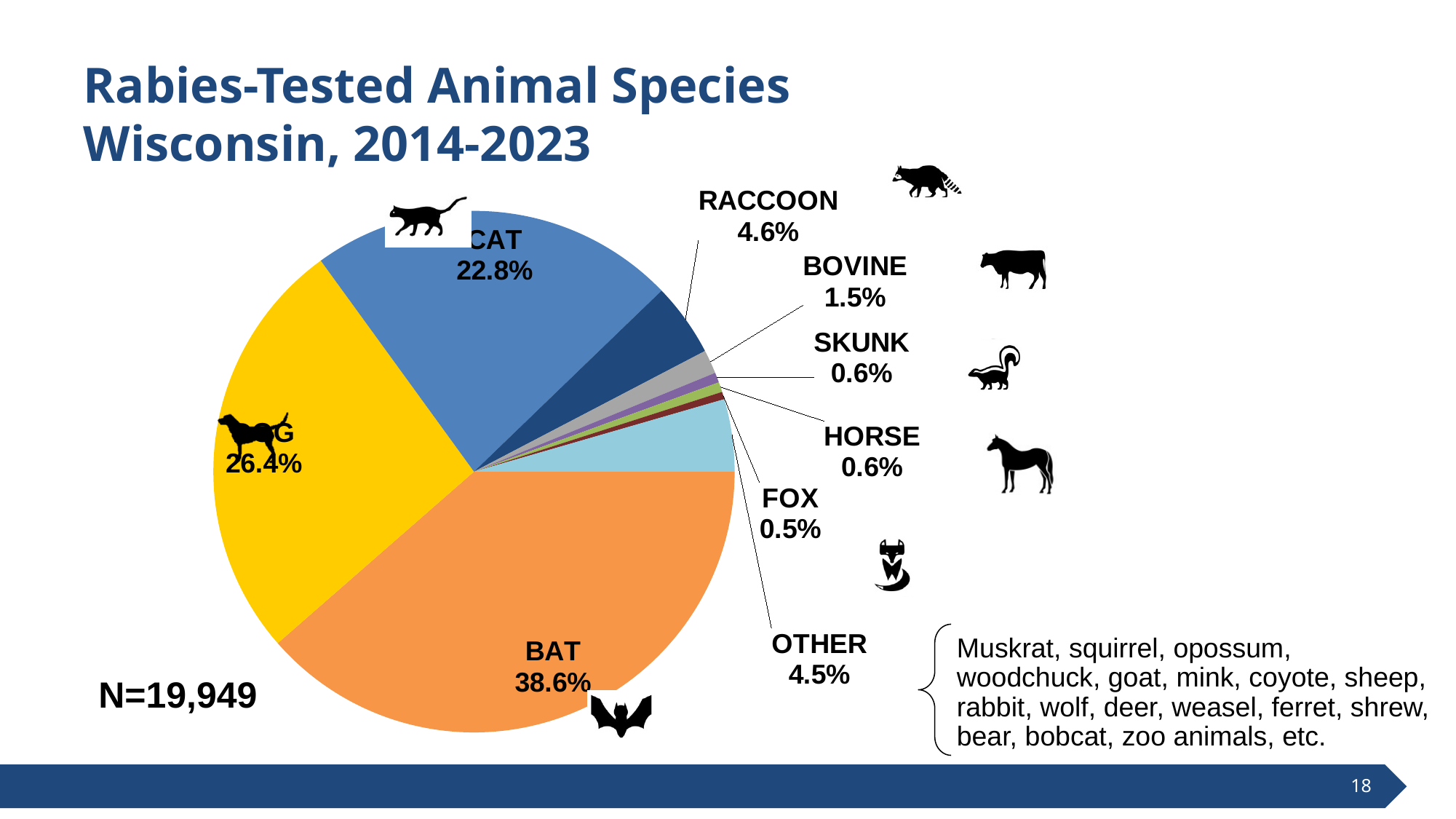
What share of rabies-tested animals were bats? 38.6% What percentage of the pie is labelled CAT? 22.8% What is the title of the chart? Rabies-Tested Animal Species Wisconsin, 2014-2023 What is the value shown for RACCOON? 4.6% What is the difference in percentage points between the BAT and CAT slices? 15.8% Which is larger, the RACCOON share or the OTHER share? RACCOON How many slices does the pie chart have? 9 Which labelled species has the smallest share of the pie? FOX What kind of chart is shown on the slide? pie chart What is the total number of animals (N) shown on the slide? N=19,949 Which animal species has the largest slice of the pie? BAT What percentage is shown for BOVINE? 1.5%